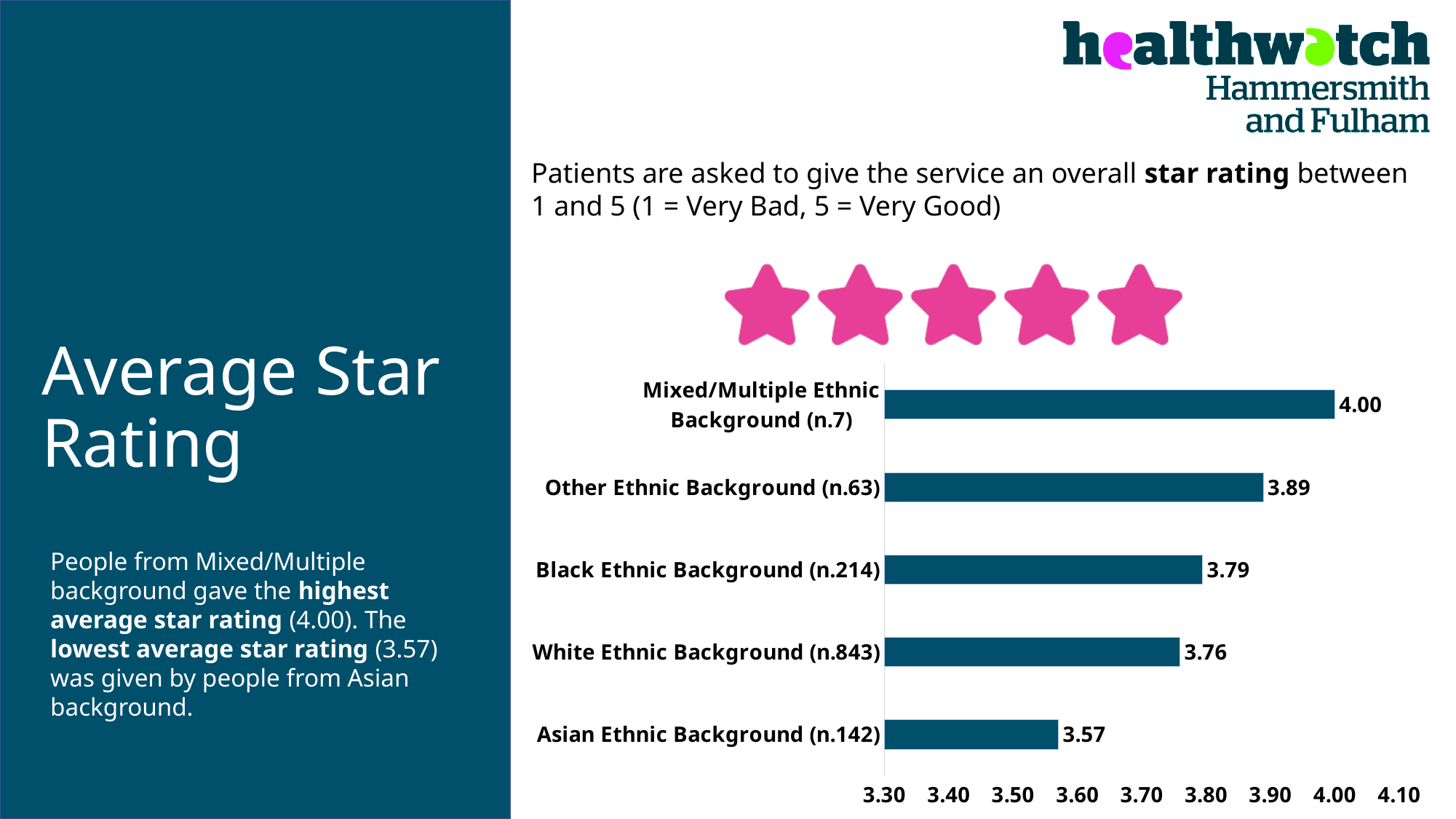
What is the average star rating for Asian Ethnic Background (n.142)? 3.57 How many ethnic background categories are shown in the chart? 5 Is the average star rating for White Ethnic Background (n.843) greater or less than 3.80? less Which ethnic background group has the highest average star rating? Mixed/Multiple Ethnic Background (n.7) What is the average star rating for Mixed/Multiple Ethnic Background (n.7)? 4.00 What is the difference between the average star rating for Mixed/Multiple Ethnic Background and Asian Ethnic Background? 0.43 Which has a higher average star rating: Other Ethnic Background (n.63) or Black Ethnic Background (n.214)? Other Ethnic Background (n.63) What kind of chart is used to show the average star ratings? Bar chart What is the average star rating for Black Ethnic Background (n.214)? 3.79 What is the average star rating for White Ethnic Background (n.843)? 3.76 What is the sample size (n) shown for the White Ethnic Background category? 843 Which ethnic background group has the lowest average star rating? Asian Ethnic Background (n.142)